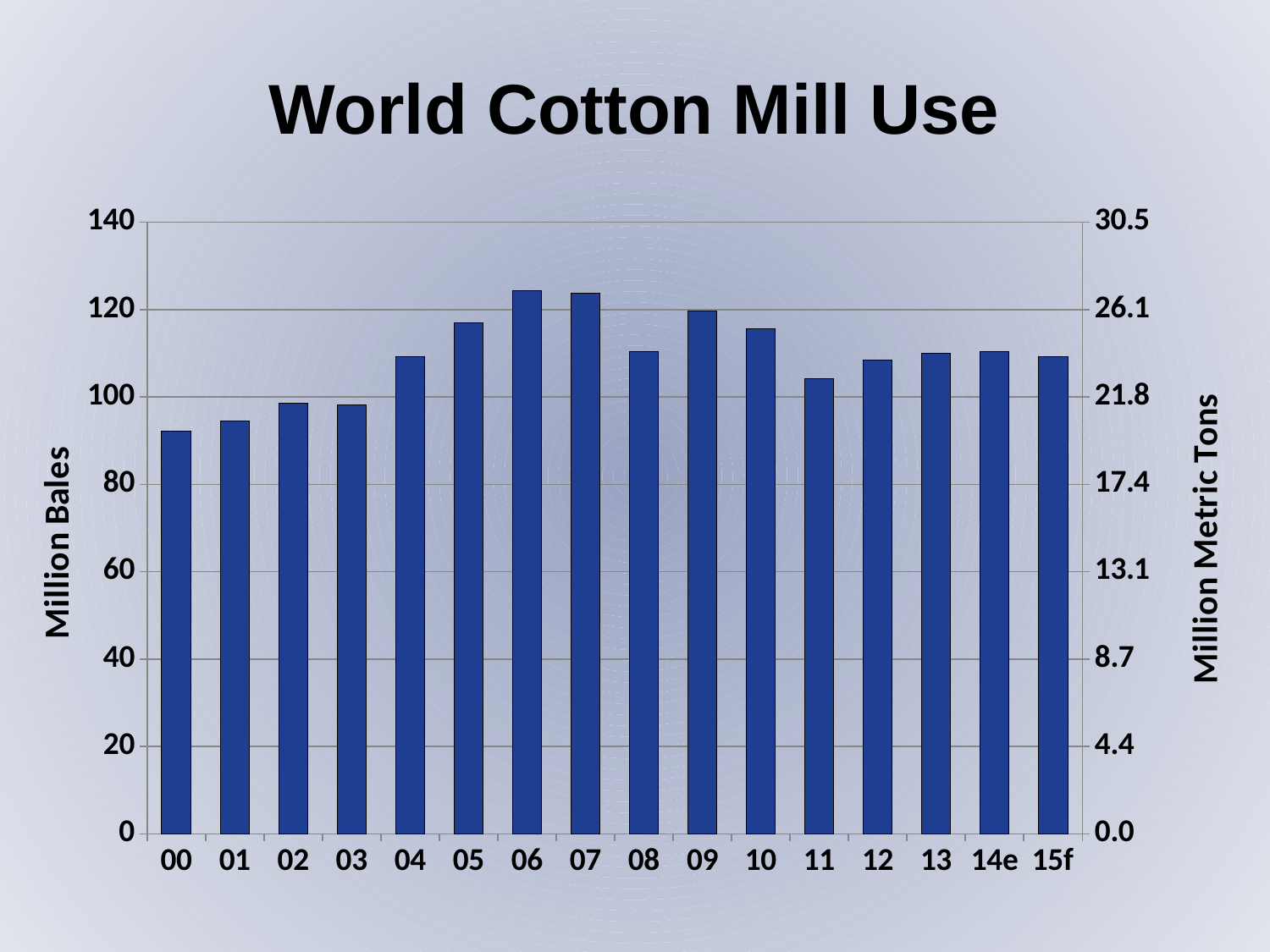
What is the label of the left vertical axis? Million Bales Is the value for 05 greater or less than 120 million bales? less Which is larger, the value for 00 or the value for 10? 10 What is the title of the chart? World Cotton Mill Use Which year has the lowest cotton mill use? 00 What kind of chart is shown on the slide? bar chart Is the value for 06 greater or less than 120 million bales? greater How many bars (years) are plotted in the chart? 16 Is the value for 00 greater or less than 100 million bales? less Which is larger, the value for 05 or the value for 11? 05 Do the values rise or fall from 00 to 06? rise